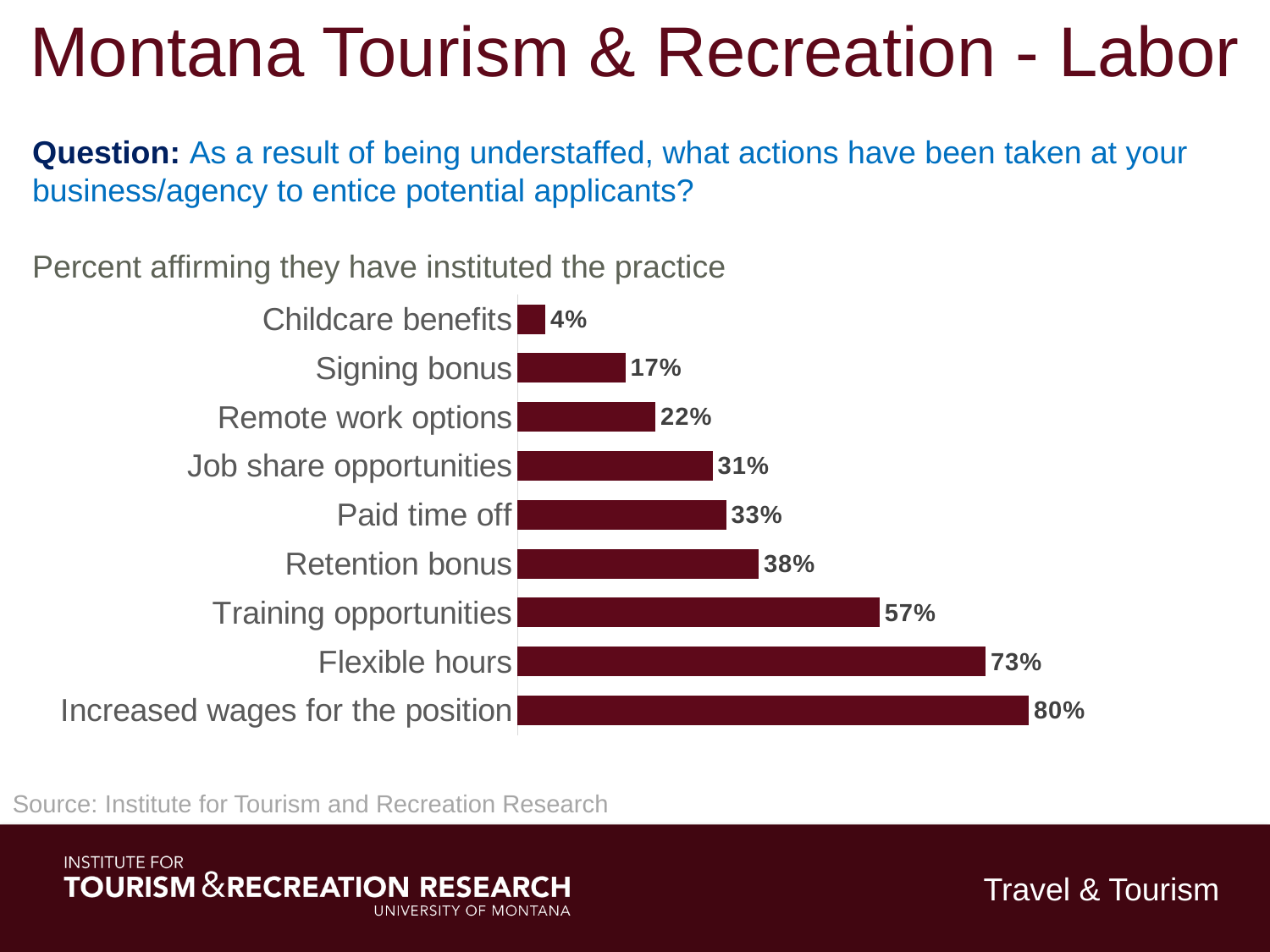
What percent of respondents affirmed they instituted increased wages for the position? 80% Which action has the lowest percent affirming? Childcare benefits Which action has the highest percent affirming? Increased wages for the position What is the difference in percentage points between Flexible hours and Training opportunities? 16 Which is larger, the value for Retention bonus or the value for Paid time off? Retention bonus What percent affirmed they offer remote work options? 22% Which is larger, the value for Job share opportunities or the value for Remote work options? Job share opportunities What is the value shown for Retention bonus? 38% What is the difference in percentage points between Paid time off and Signing bonus? 16 What is the subtitle printed directly above the chart? Percent affirming they have instituted the practice What kind of chart is shown on the slide? Bar chart How many actions (categories) are shown in the chart? 9